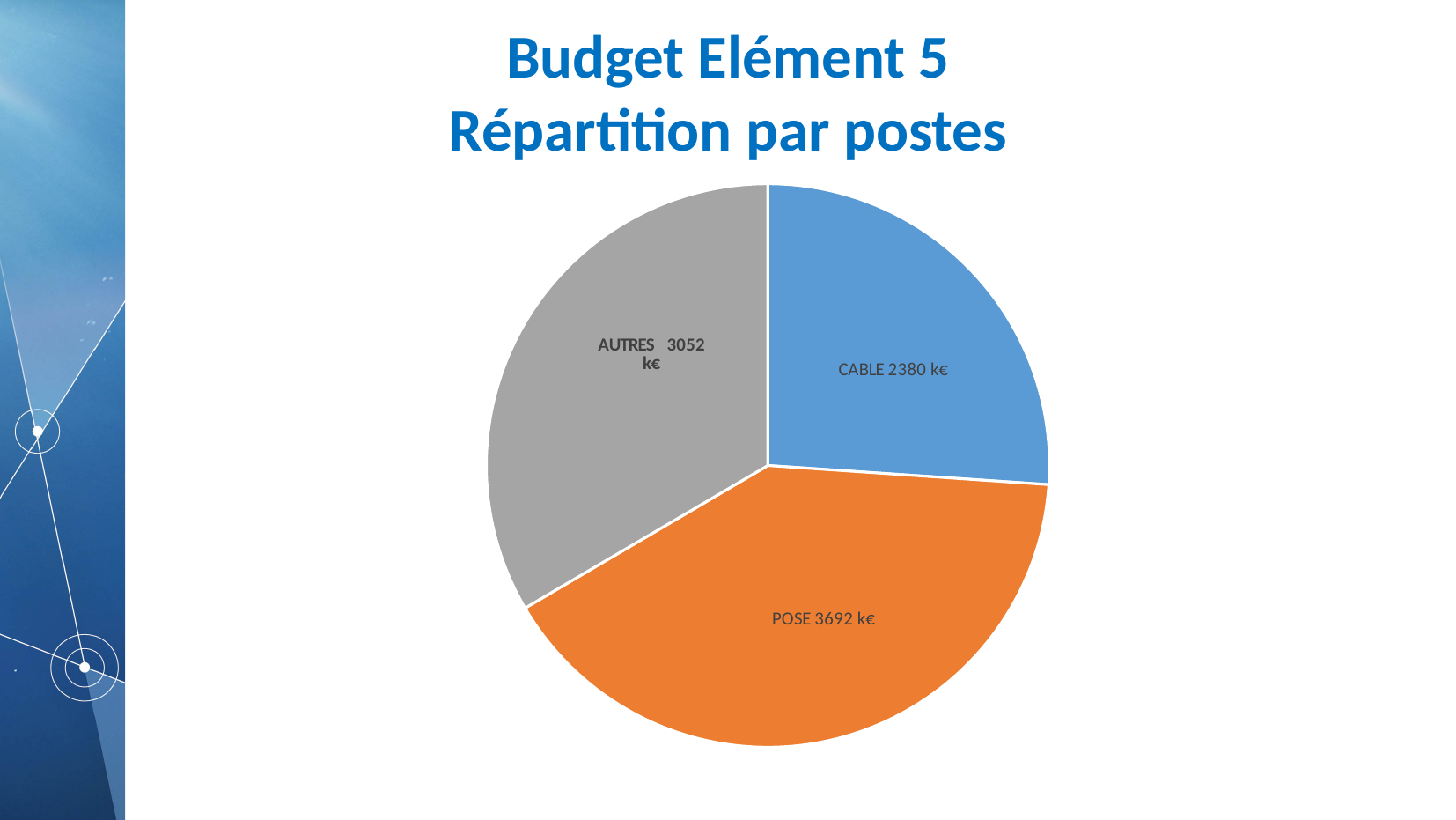
What is the value for CABLE? 2380 k€ What is the difference between the values for POSE and CABLE? 1312 k€ What is the title of the slide containing the chart? Budget Elément 5 Répartition par postes Which is larger, the value for AUTRES or the value for CABLE? AUTRES How many slices does the pie chart have? 3 What kind of chart is shown on the slide? Pie chart What is the difference between the values for AUTRES and CABLE? 672 k€ Which category has the largest value? POSE What is the value for AUTRES? 3052 k€ What is the total of all slices in the pie chart? 9124 k€ Which category has the smallest value? CABLE What is the value for POSE? 3692 k€